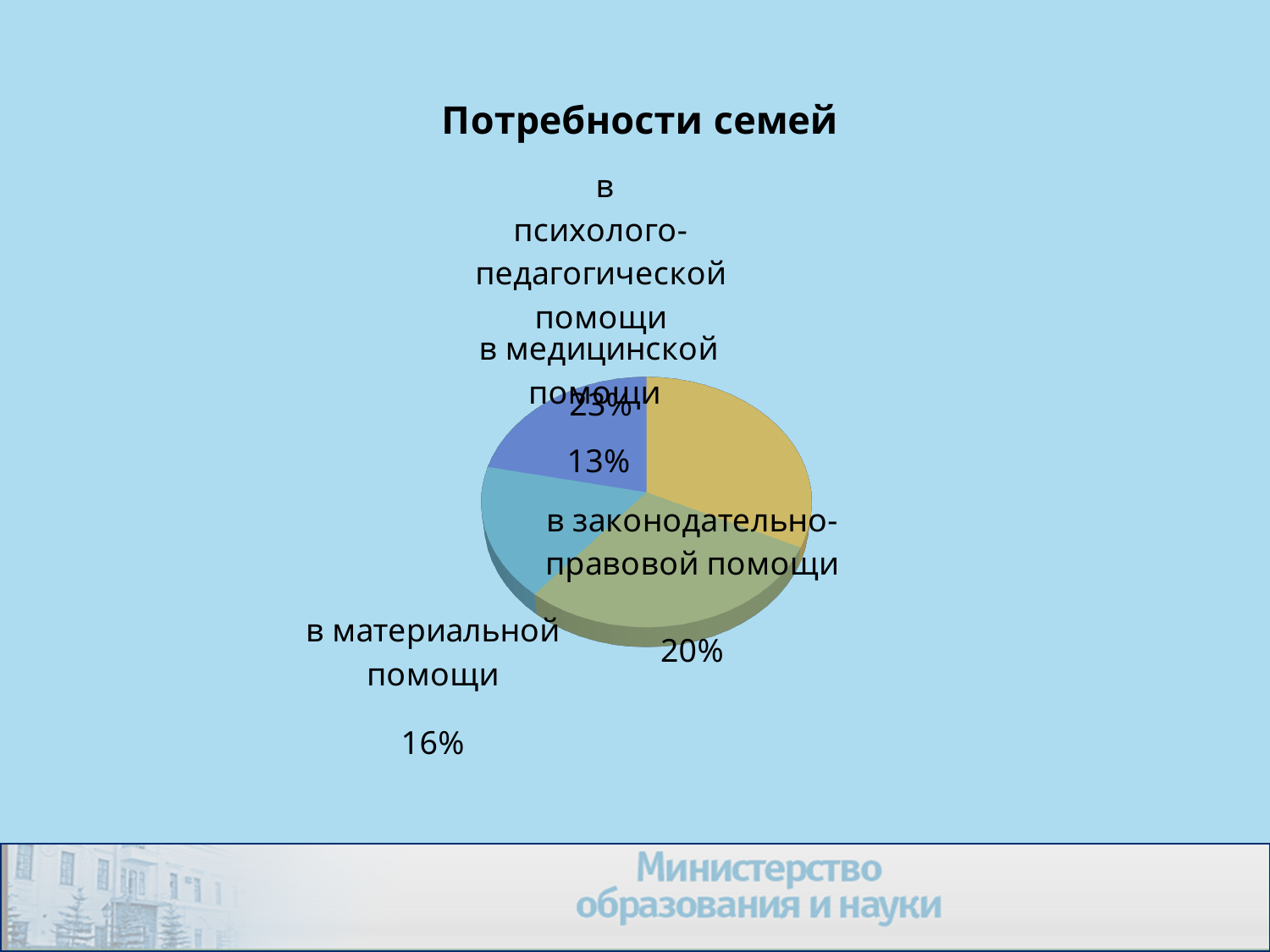
How many slices does the pie chart have? 4 Which category has the largest slice of the pie? в психолого-педагогической помощи What is the difference between the values for "в законодательно-правовой помощи" and "в медицинской помощи"? 7% What is the value shown for "в материальной помощи"? 16% What kind of chart is shown on the slide? pie chart What is the value shown for "в медицинской помощи"? 13% What colour is the slice for "в законодательно-правовой помощи"? green What is the value shown for "в законодательно-правовой помощи"? 20% What is the title of the chart? Потребности семей Which is larger: the value for "в материальной помощи" or "в медицинской помощи"? в материальной помощи Which category has the smallest slice of the pie? в медицинской помощи What is the difference between the values for "в законодательно-правовой помощи" and "в материальной помощи"? 4%